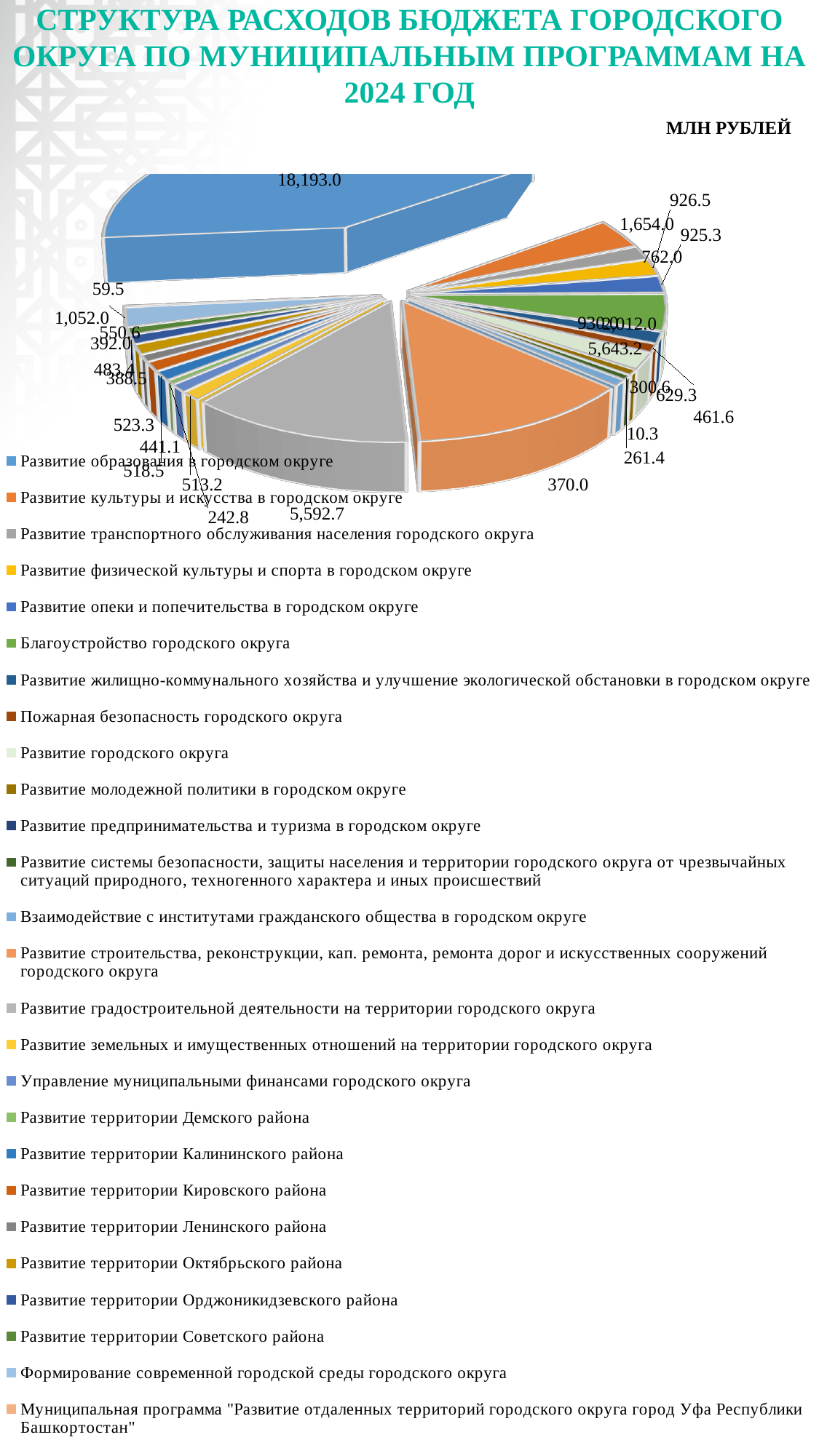
What is the value shown for Развитие культуры и искусства в городском округе? 1,654.0 What is the value shown for Развитие образования в городском округе? 18,193.0 In what units are the values on the chart expressed? МЛН РУБЛЕЙ What year does the chart title refer to? 2024 What is the difference between the values for Развитие культуры и искусства в городском округе and Развитие транспортного обслуживания населения городского округа? 892.0 What is the difference between the values for Развитие образования в городском округе and Развитие культуры и искусства в городском округе? 16,539.0 What is the smallest value labelled on the pie chart? 10.3 Which is larger: the value for Развитие культуры и искусства в городском округе or for Развитие транспортного обслуживания населения городского округа? Развитие культуры и искусства в городском округе What kind of chart is shown on the slide? pie chart How many programmes are listed in the chart legend? 26 Which programme has the largest share of the budget expenditure in the pie chart? Развитие образования в городском округе What is the value shown for Развитие транспортного обслуживания населения городского округа? 762.0